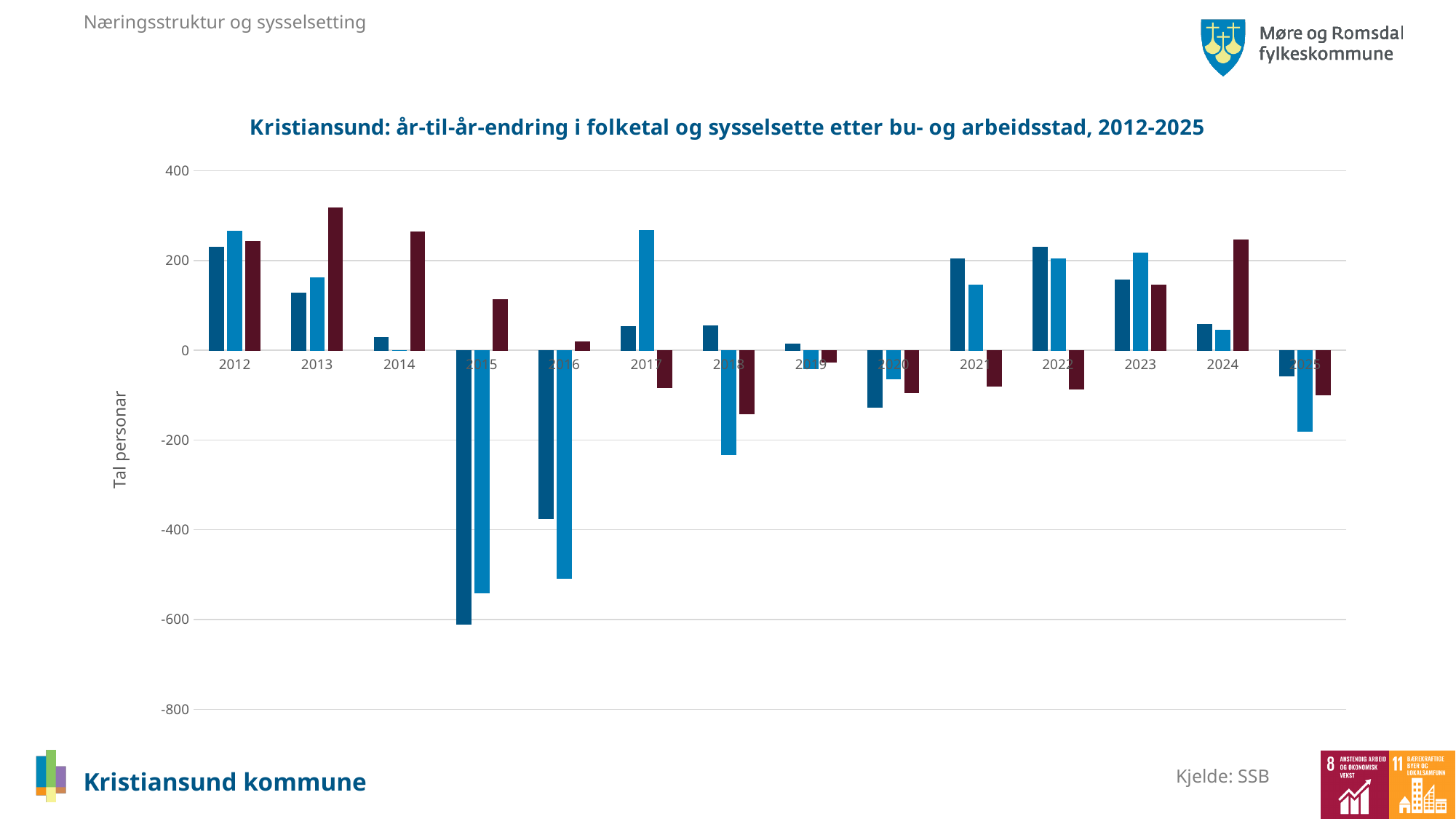
Is the value of the light blue bar for 2015 greater or less than -400? less Is the value of the light blue bar for 2017 greater or less than 200? greater Is the value of the dark blue bar for 2016 greater or less than -200? less What is the label on the vertical axis of the chart? Tal personar What kind of chart is shown on the slide? bar chart In which year does the dark blue bar reach its lowest value? 2015 How many years are shown along the x axis of the chart? 14 What is the title of the chart? Kristiansund: år-til-år-endring i folketal og sysselsette etter bu- og arbeidsstad, 2012-2025 Which is larger, the dark red bar for 2013 or the dark red bar for 2014? 2013 In which year is the dark red bar the highest? 2013